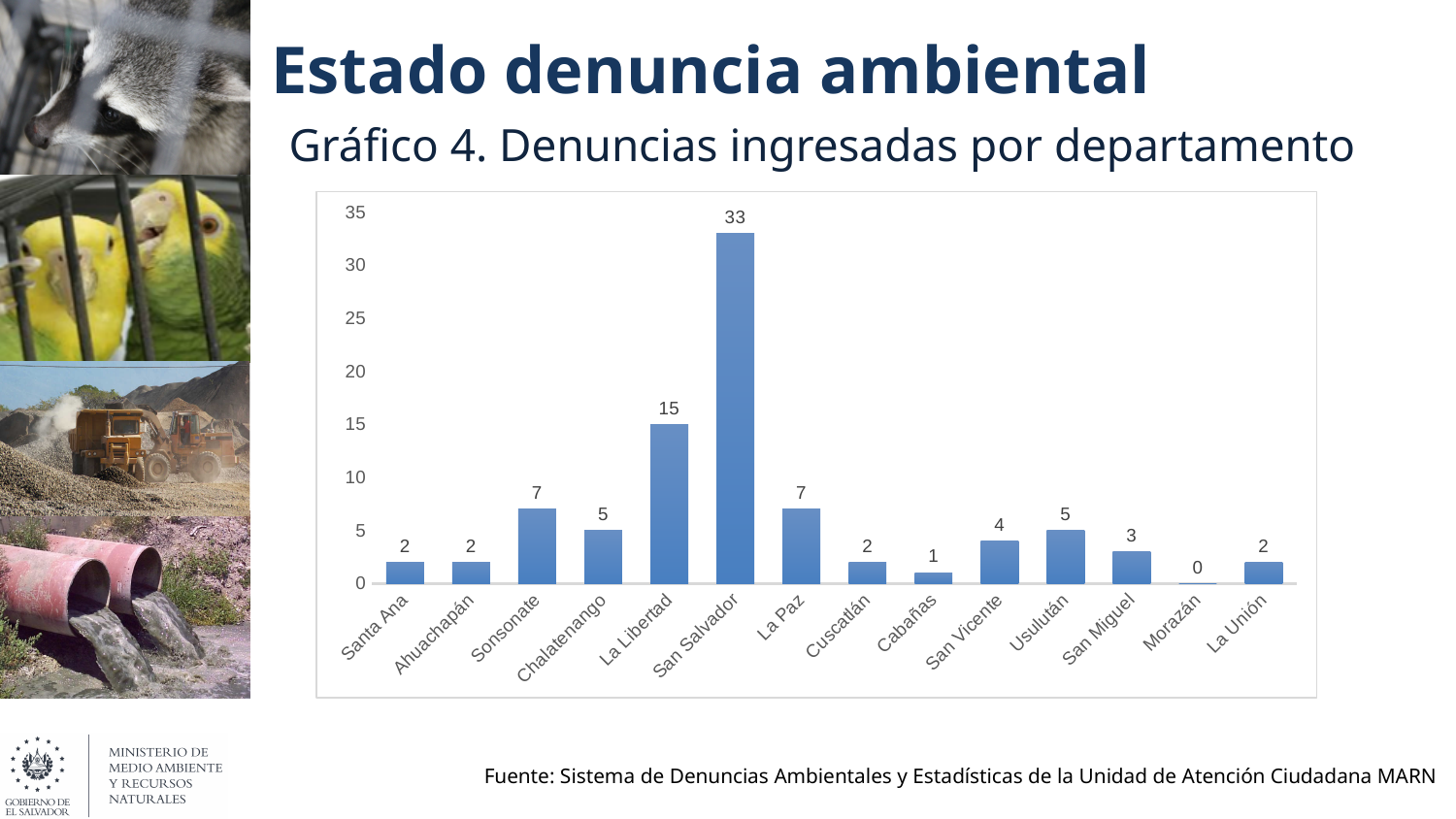
What is the value shown for Cabañas? 1 Is the value for San Salvador greater or less than 30? greater What is the difference between the values for San Salvador and La Libertad? 18 What is the title of the chart? Gráfico 4. Denuncias ingresadas por departamento How many departments are shown on the x axis? 14 What is the value shown for La Libertad? 15 What is the value shown for Usulután? 5 Which department has the lowest number of complaints? Morazán How many complaints (denuncias) were entered for San Salvador? 33 What kind of chart is shown on the slide? Bar chart Which department has the highest number of complaints? San Salvador Which has a larger value, Sonsonate or Chalatenango? Sonsonate